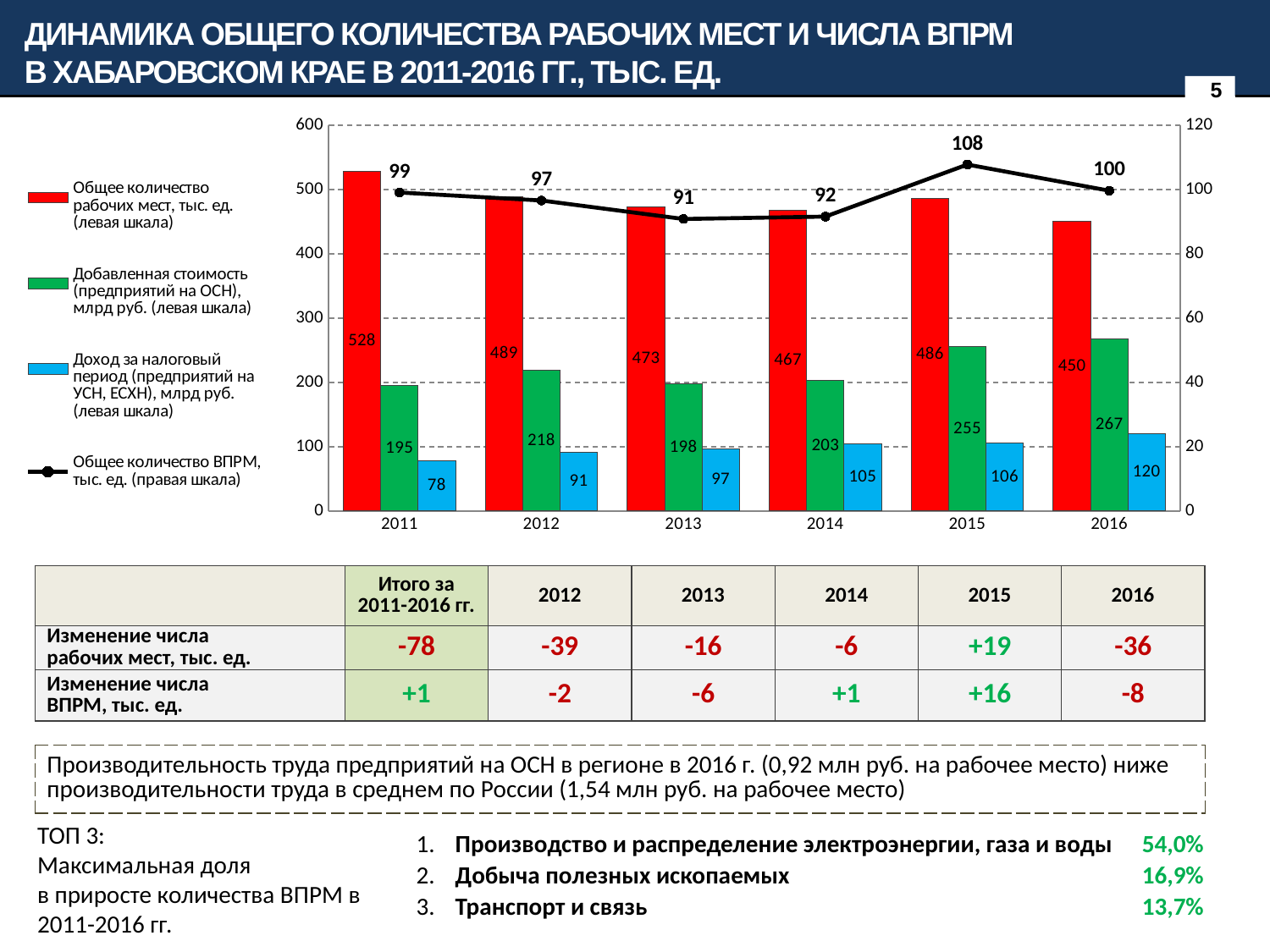
How many years are shown on the x axis of the chart? 6 What is the total number of jobs (Общее количество рабочих мест) shown for 2011? 528 Do the blue bars (Доход за налоговый период) rise or fall from 2011 to 2016? rise In which year is the red bar (Общее количество рабочих мест) the highest? 2011 In which year is the green bar (Добавленная стоимость) the lowest? 2011 What is the value of Доход за налоговый период (blue bar) for 2016? 120 How many series does the chart legend list? 4 Is the value of Общее количество ВПРМ for 2013 greater or less than 100 on the right axis? less What kind of chart is shown on the slide? Combined bar and line chart What value does the line for Общее количество ВПРМ show for 2015? 108 By how much did the total number of jobs (red bars) change from 2011 to 2016? -78 Which is larger: the Добавленная стоимость value for 2015 or for 2016? 2016